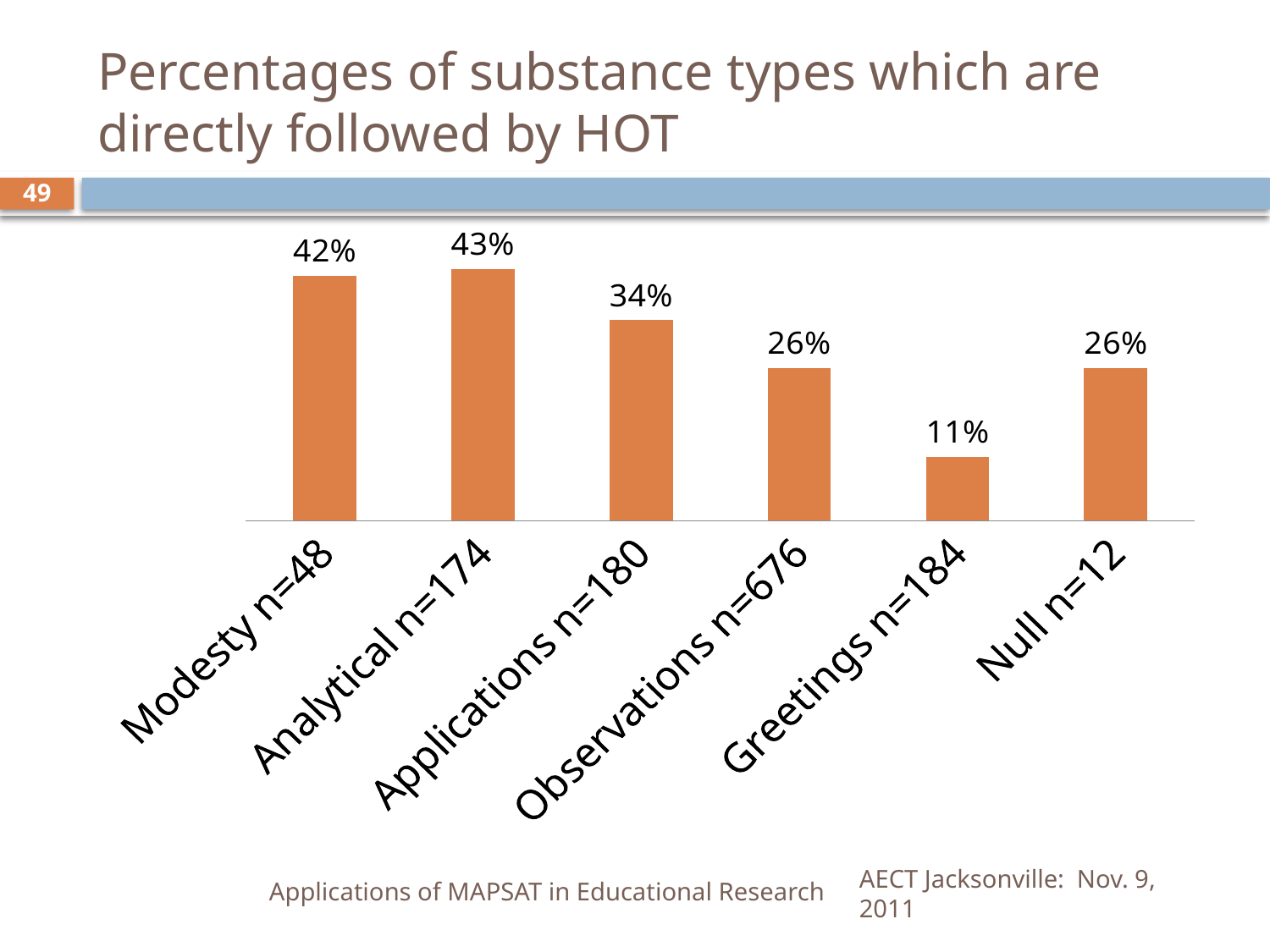
What percentage is shown for Applications n=180? 34% What kind of chart is shown on the slide? Bar chart How many categories are shown in the chart? 6 Which category has the highest percentage? Analytical n=174 Which category has the lowest percentage? Greetings n=184 Which is larger, the percentage for Applications n=180 or for Observations n=676? Applications n=180 What is the title of the slide? Percentages of substance types which are directly followed by HOT What percentage is shown for Modesty n=48? 42% What is the difference between the percentages for Analytical n=174 and Greetings n=184? 32% What is the difference between the percentages for Modesty n=48 and Applications n=180? 8% What percentage is shown for Null n=12? 26% What percentage is shown for Greetings n=184? 11%